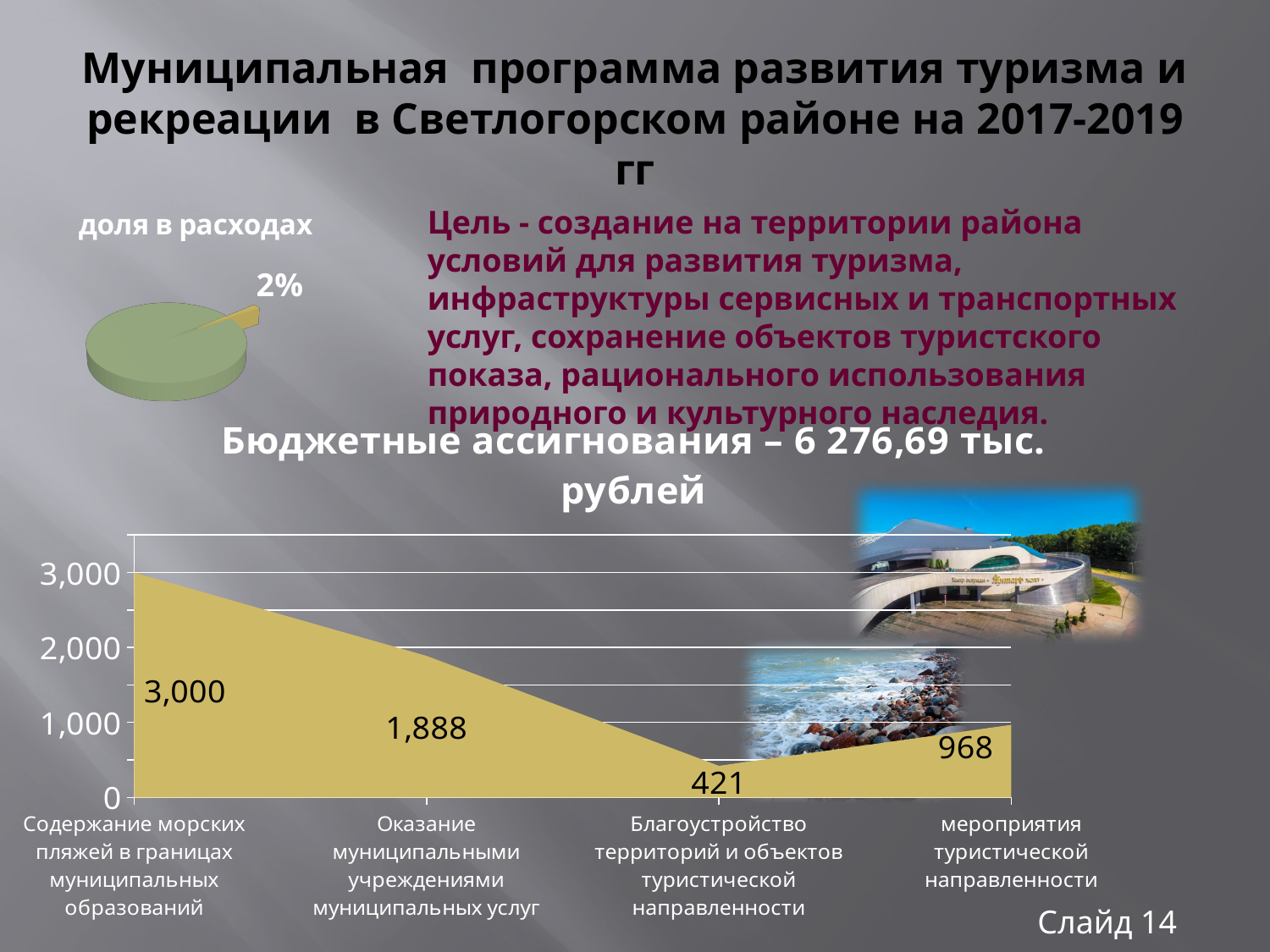
On the 'Бюджетные ассигнования' chart, what is the difference between the values for 'Содержание морских пляжей' and 'Оказание муниципальными учреждениями муниципальных услуг'? 1,112 On the 'Бюджетные ассигнования' chart, which category has the highest value? Содержание морских пляжей в границах муниципальных образований On the 'Бюджетные ассигнования' chart, what is the value for 'Содержание морских пляжей в границах муниципальных образований'? 3,000 On the 'Бюджетные ассигнования' chart, which category has the lowest value? Благоустройство территорий и объектов туристической направленности How many categories are shown on the 'Бюджетные ассигнования' chart? 4 On the 'доля в расходах' pie chart, what share is shown for the highlighted slice? 2% On the 'Бюджетные ассигнования' chart, which is larger: the value for 'мероприятия туристической направленности' or for 'Благоустройство территорий и объектов туристической направленности'? мероприятия туристической направленности On the 'Бюджетные ассигнования' chart, what is the value for 'мероприятия туристической направленности'? 968 What kind of chart is the 'доля в расходах' chart? Pie chart What kind of chart is the 'Бюджетные ассигнования' chart? Area chart On the 'Бюджетные ассигнования' chart, what is the value for 'Оказание муниципальными учреждениями муниципальных услуг'? 1,888 On the 'Бюджетные ассигнования' chart, what is the value for 'Благоустройство территорий и объектов туристической направленности'? 421